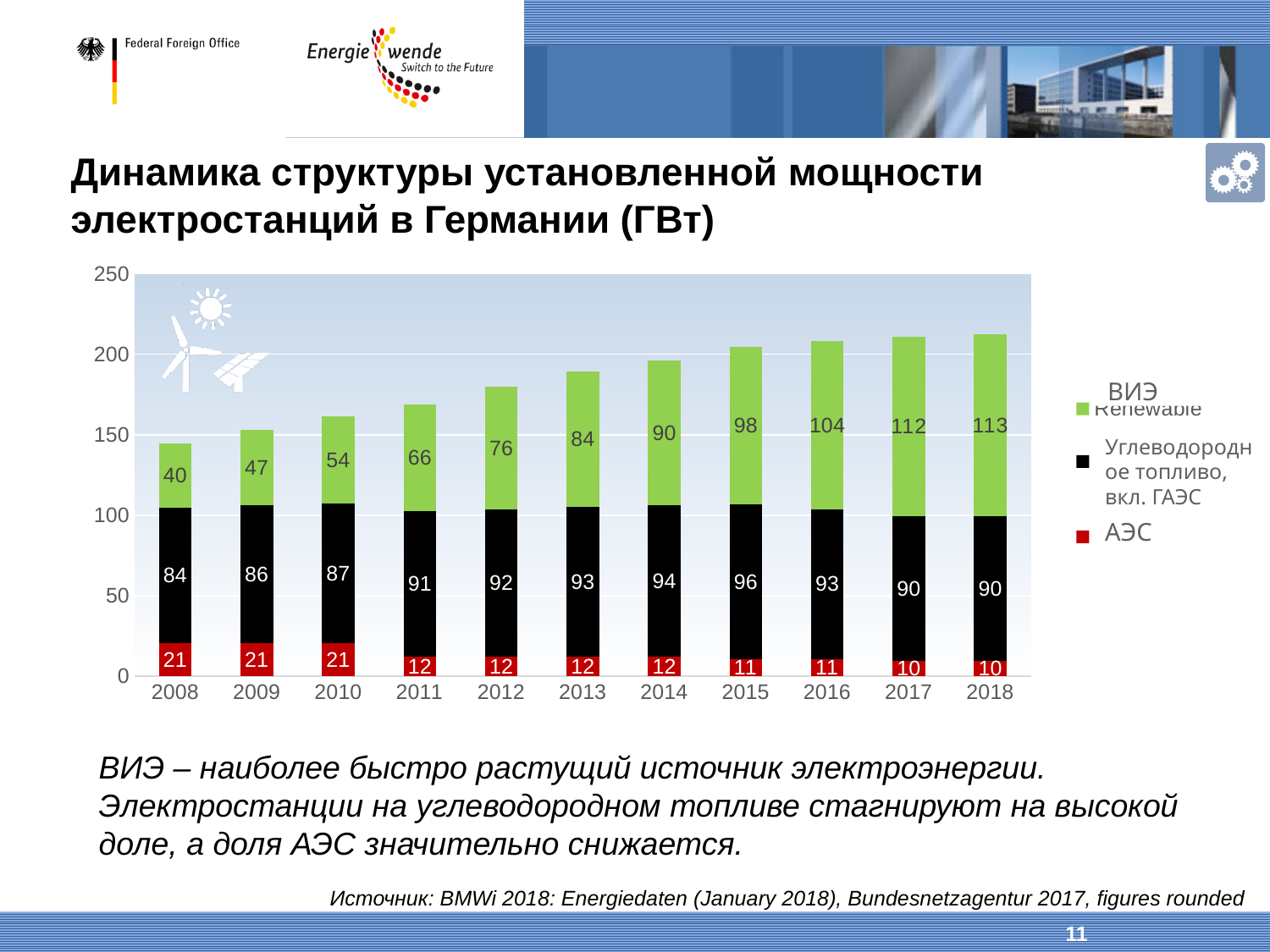
What is the value for ВИЭ (Renewable) in 2012? 76 How many series does the legend list? 3 In which year is the ВИЭ (Renewable) value highest? 2018 What is the value for АЭС in 2008? 21 What is the value for Углеводородное топливо, вкл. ГАЭС in 2015? 96 Does the ВИЭ (Renewable) value rise or fall from 2008 to 2018? rise Is the total of the stacked bar for 2018 greater or less than 200? greater By how much did the ВИЭ (Renewable) value increase from 2008 to 2018? 73 What is the total of the stacked bar for 2008? 145 In 2014, which is larger: the ВИЭ (Renewable) value or the Углеводородное топливо, вкл. ГАЭС value? Углеводородное топливо, вкл. ГАЭС In which year is the Углеводородное топливо, вкл. ГАЭС value highest? 2015 How many years are shown on the x axis? 11